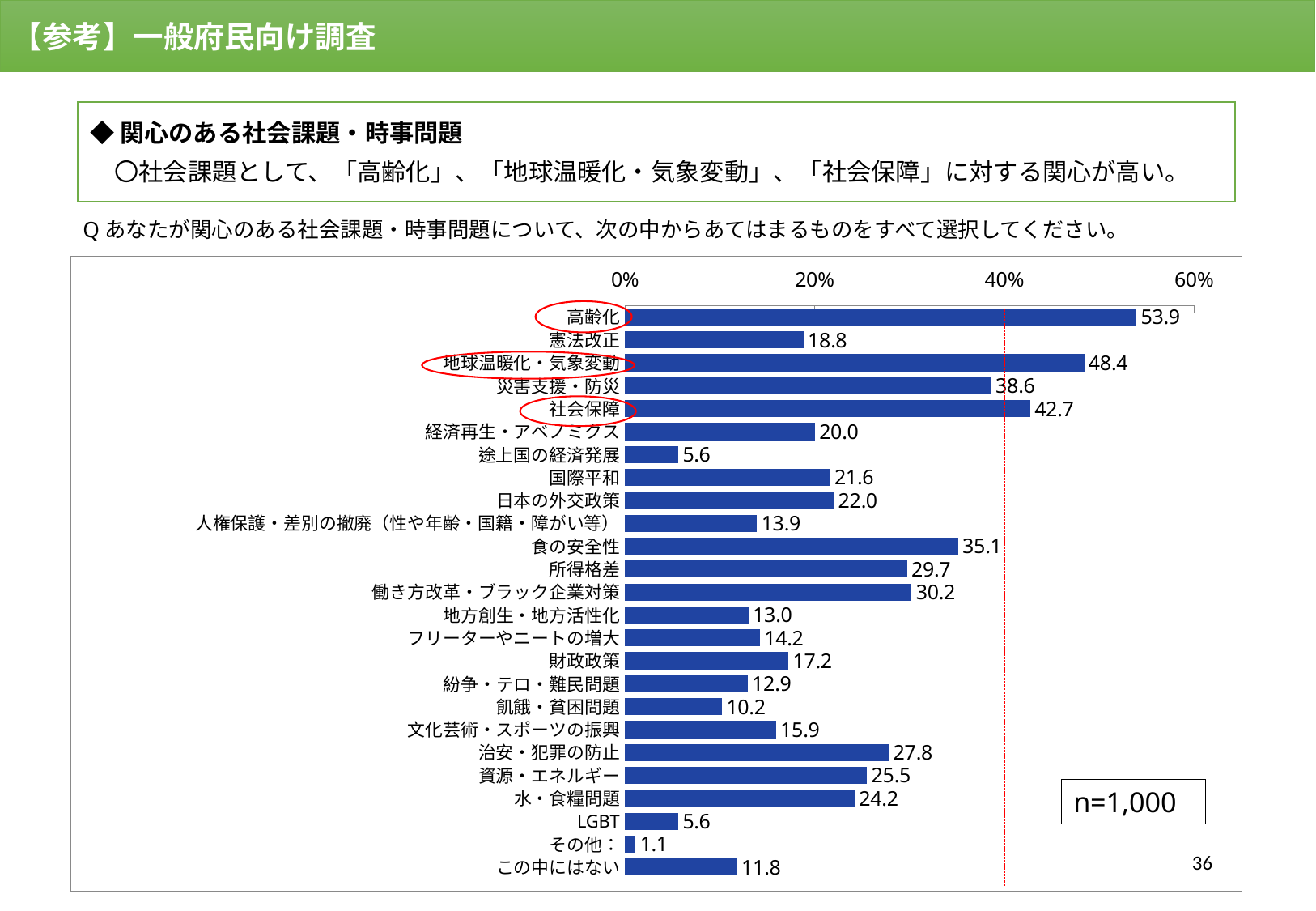
Which category has the highest value? 高齢化 How many categories are shown in the chart? 25 Which is larger, the value for 食の安全性 or the value for 所得格差? 食の安全性 What kind of chart is shown on the slide? bar chart What is the value for 地球温暖化・気象変動? 48.4 What is the value for 高齢化? 53.9 Is the value for 災害支援・防災 greater or less than 40%? less What is the value for 社会保障? 42.7 What is the difference between the values for 高齢化 and 地球温暖化・気象変動? 5.5 Which category has the lowest value? その他 What sample size is shown in the box on the chart? n=1,000 What is the value for LGBT? 5.6